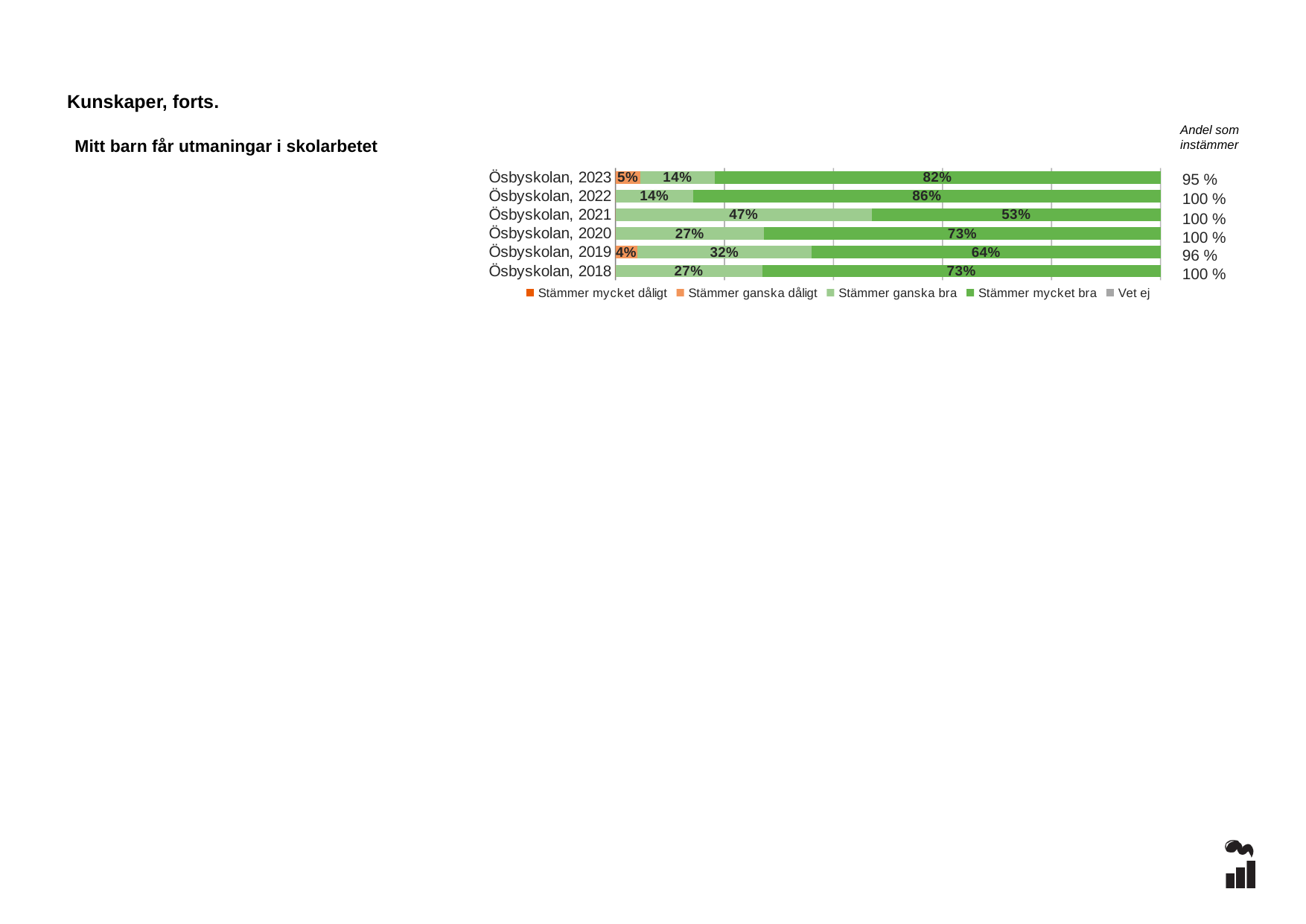
What is the value for 'Stämmer ganska dåligt' for Ösbyskolan, 2019? 4% How many categories (bars) are shown in the chart? 6 What is the 'Andel som instämmer' value shown for Ösbyskolan, 2023? 95 % Which is larger: the 'Stämmer ganska bra' value for Ösbyskolan, 2019 or for Ösbyskolan, 2020? Ösbyskolan, 2019 How many series does the legend list? 5 What is the difference between the 'Stämmer mycket bra' values for Ösbyskolan, 2022 and Ösbyskolan, 2021? 33 percentage points What is the value for 'Stämmer ganska bra' for Ösbyskolan, 2021? 47% What is the title of the question shown above the chart? Mitt barn får utmaningar i skolarbetet What kind of chart is shown on the slide? stacked bar chart Which year has the lowest value for 'Stämmer mycket bra'? Ösbyskolan, 2021 What is the value for 'Stämmer mycket bra' for Ösbyskolan, 2023? 82% Which year has the highest value for 'Stämmer mycket bra'? Ösbyskolan, 2022